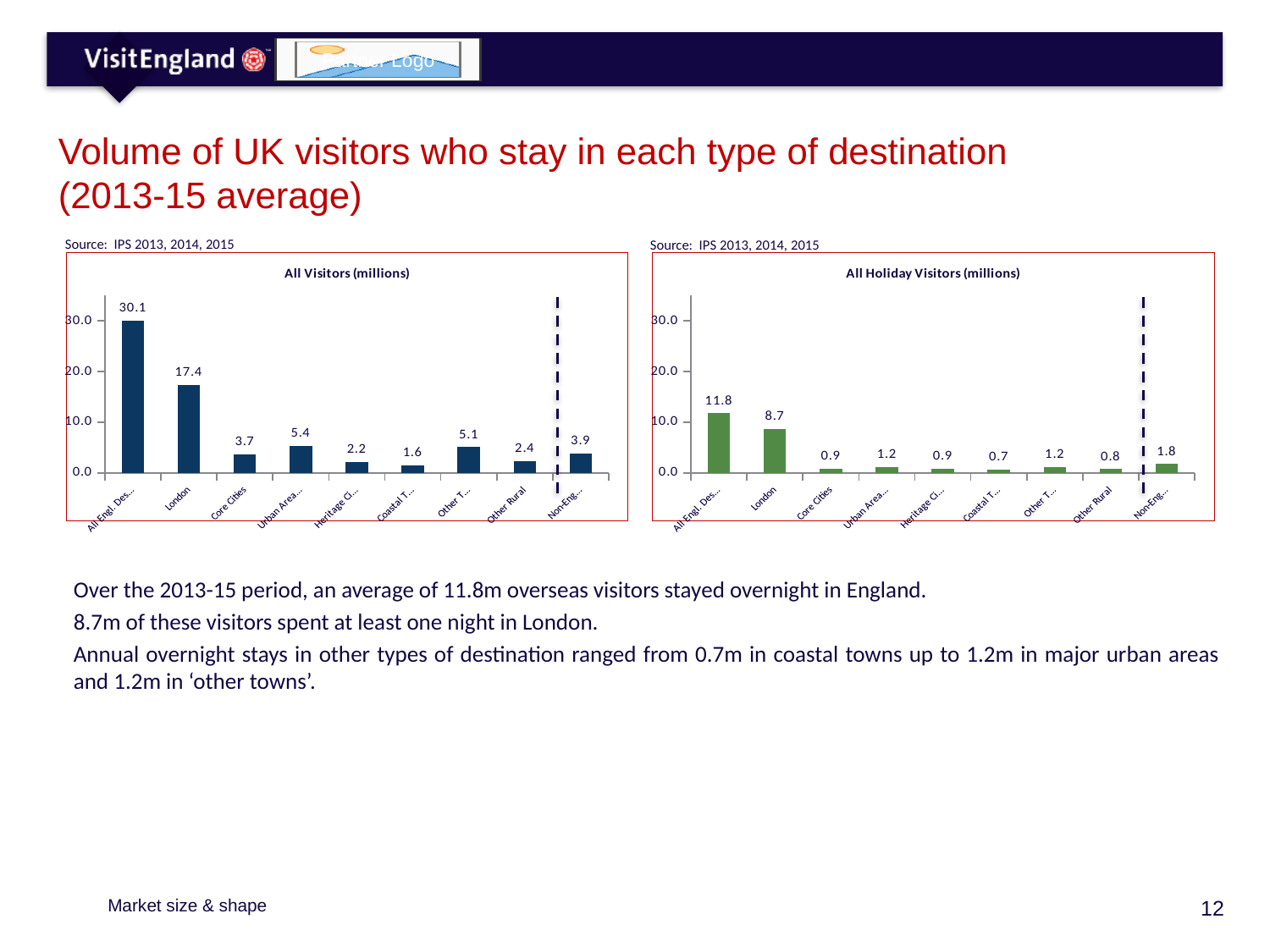
In the 'All Visitors (millions)' chart, what is the value for Other Rural? 2.4 In the 'All Visitors (millions)' chart, which is larger: the value for Core Cities or the value for Other Rural? Core Cities In the 'All Holiday Visitors (millions)' chart, what is the difference between the values for London and Other Rural? 7.9 In the 'All Holiday Visitors (millions)' chart, what is the value for London? 8.7 In the 'All Visitors (millions)' chart, which category has the highest value? All Engl. Des... In the 'All Holiday Visitors (millions)' chart, what is the value for Other Rural? 0.8 In the 'All Holiday Visitors (millions)' chart, what is the value for Core Cities? 0.9 In the 'All Visitors (millions)' chart, what is the value for Core Cities? 3.7 In the 'All Visitors (millions)' chart, what is the value for London? 17.4 How many categories are shown on the x axis of the 'All Holiday Visitors (millions)' chart? 9 In the 'All Visitors (millions)' chart, what is the difference between the values for London and Core Cities? 13.7 What type of chart is the 'All Visitors (millions)' chart? Bar chart